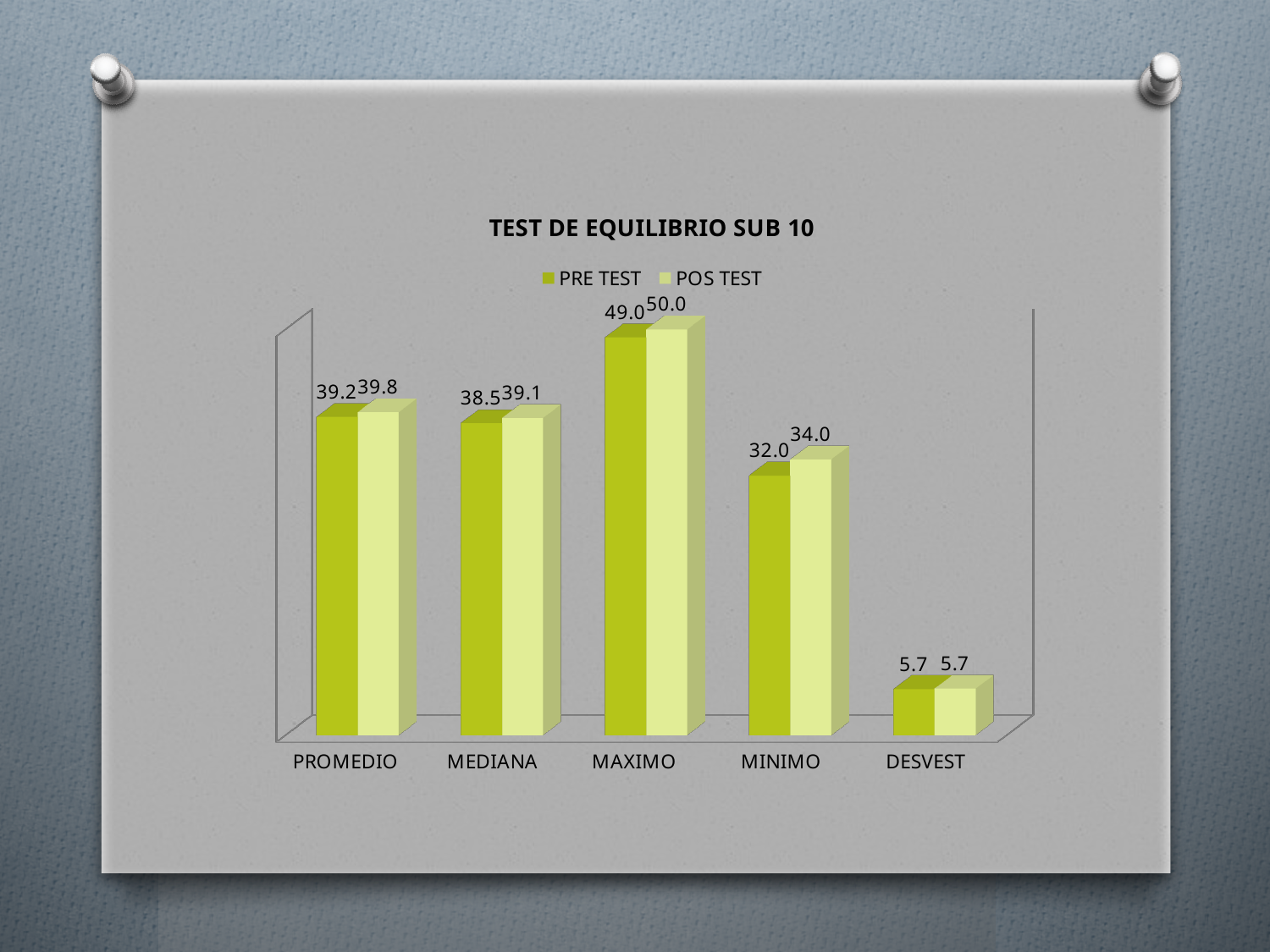
What is the PRE TEST value for PROMEDIO? 39.2 What is the title of the chart? TEST DE EQUILIBRIO SUB 10 What is the POS TEST value for MAXIMO? 50.0 Which category has the lowest POS TEST value? DESVEST How many categories are shown on the x axis? 5 What is the POS TEST value for MINIMO? 34.0 What is the difference between the PRE TEST values for MAXIMO and MEDIANA? 10.5 Which is larger for MEDIANA, the PRE TEST value or the POS TEST value? POS TEST What kind of chart is shown on the slide? Bar chart How many series does the legend list? 2 What is the difference between the POS TEST and PRE TEST values for MINIMO? 2.0 Which category has the highest PRE TEST value? MAXIMO